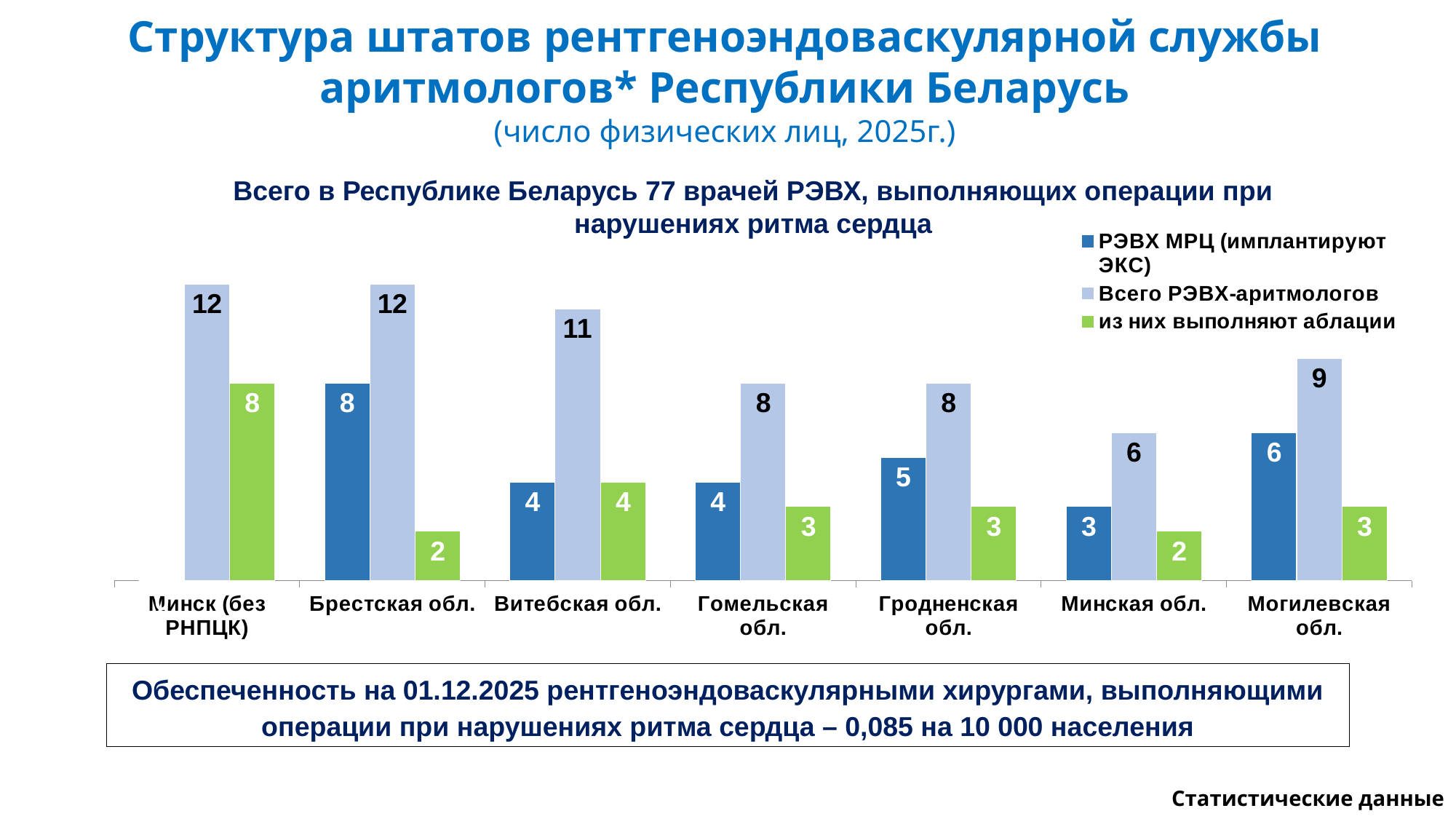
Which category has the lowest value of "Всего РЭВХ-аритмологов"? Минская обл. How many series does the legend list? 3 What is the difference between "Всего РЭВХ-аритмологов" and "из них выполняют аблации" for Брестская обл.? 10 What is the value of "РЭВХ МРЦ (имплантируют ЭКС)" for Гродненская обл.? 5 How many categories are shown on the x axis? 7 What is the value of "Всего РЭВХ-аритмологов" for Витебская обл.? 11 Which is larger: "из них выполняют аблации" for Витебская обл. or for Могилевская обл.? Витебская обл. Which series is shown in green? из них выполняют аблации What is the value of "из них выполняют аблации" for Минск (без РНПЦК)? 8 Which category has the highest value of "РЭВХ МРЦ (имплантируют ЭКС)"? Брестская обл. What is the chart title? Всего в Республике Беларусь 77 врачей РЭВХ, выполняющих операции при нарушениях ритма сердца What kind of chart is shown on the slide? bar chart